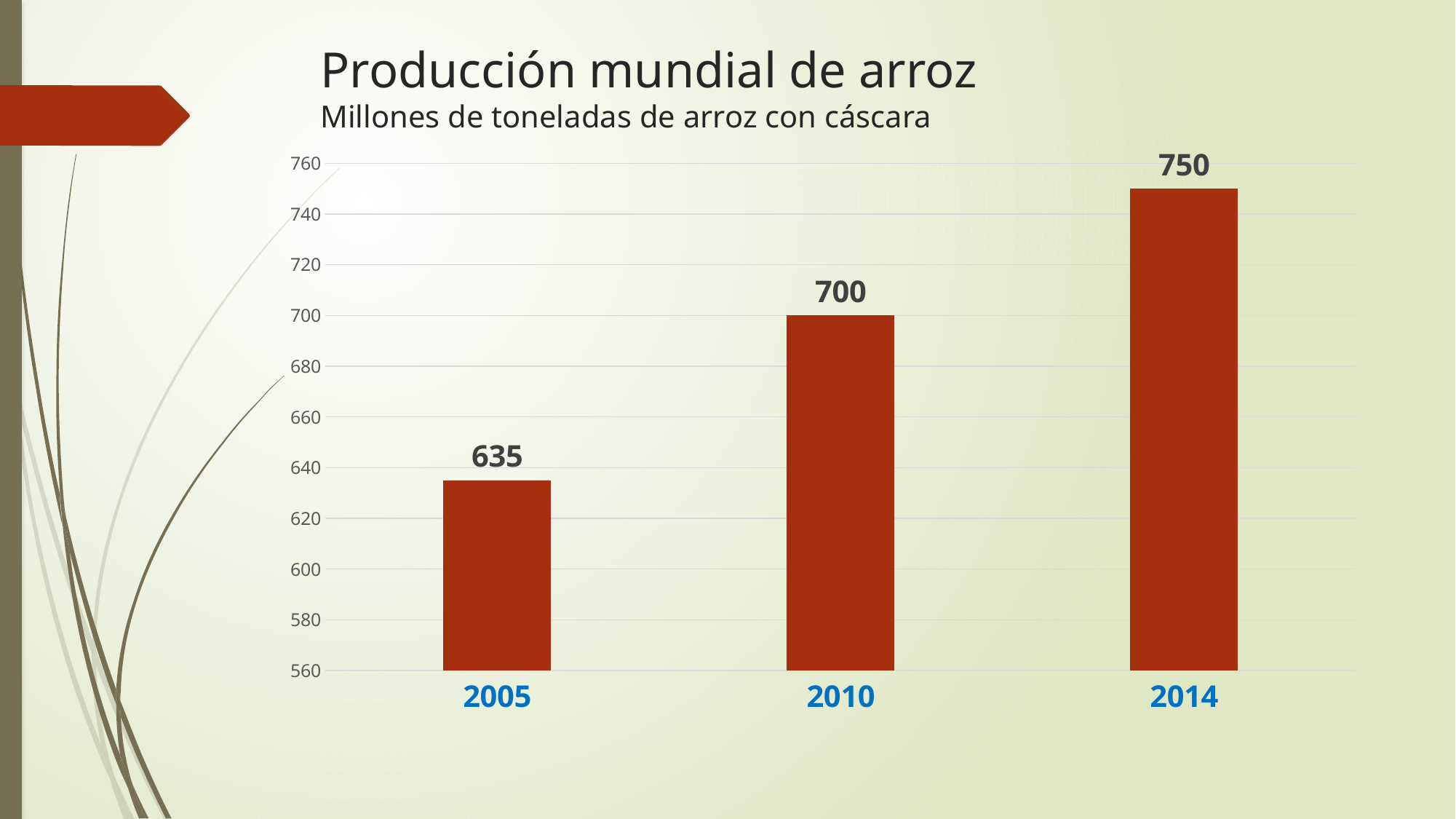
What is the difference between the values for 2010 and 2005? 65 Is the value for 2005 greater or less than 640? less What is the value for 2010? 700 What is the value for 2014? 750 How many years are shown on the chart? 3 What is the difference between the values for 2014 and 2005? 115 What kind of chart is shown on the slide? bar chart Do the values rise or fall from 2005 to 2014? rise What is the value for 2005? 635 Which year has the lowest value? 2005 Which year has the highest value? 2014 Which is larger, the value for 2010 or the value for 2014? 2014